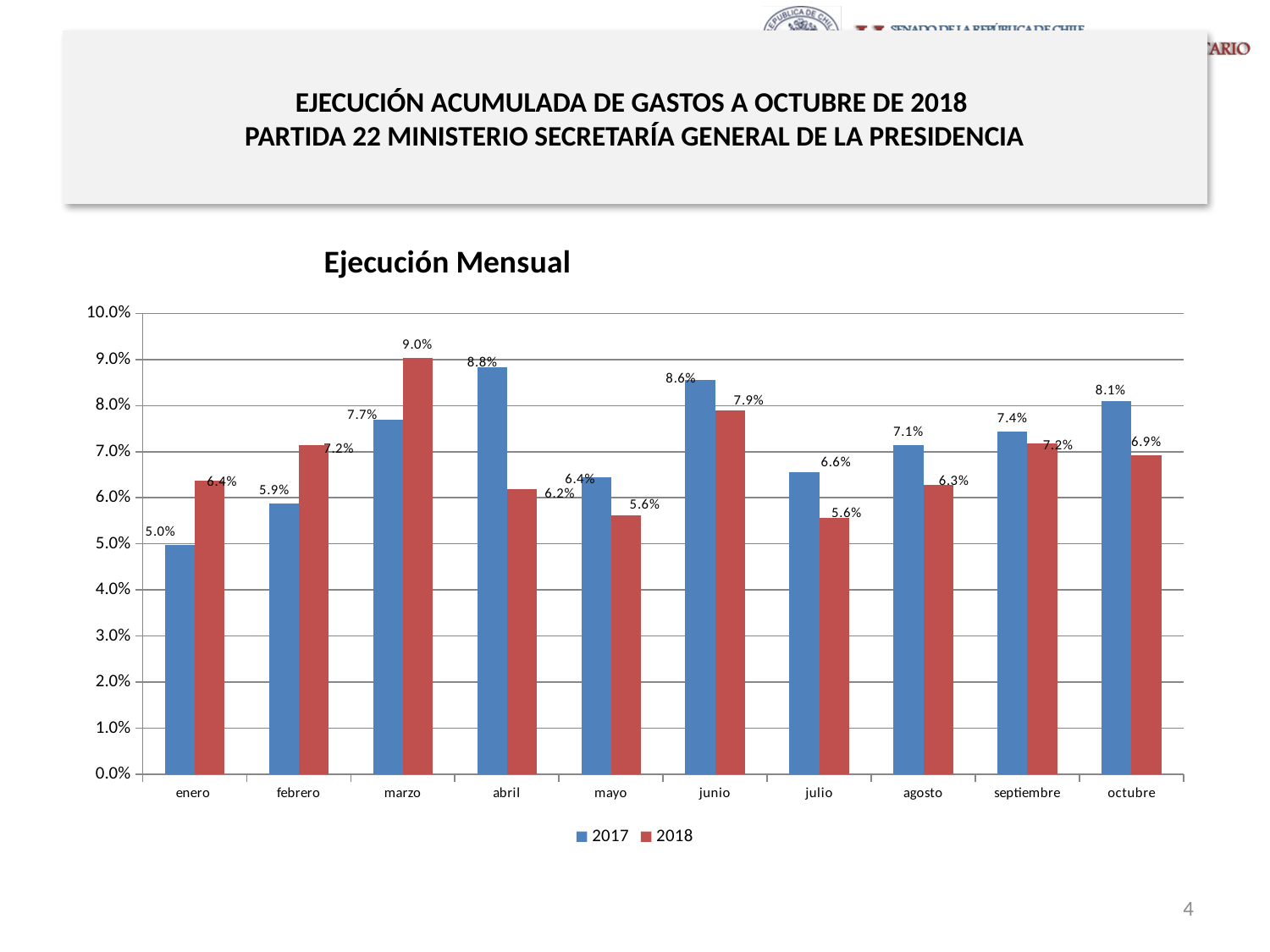
What is the value for 2017 in enero? 5.0% Which month has the highest value for the 2018 series? marzo What is the value for 2018 in marzo? 9.0% Which month has the lowest value for the 2017 series? enero What is the value for 2018 in octubre? 6.9% What is the difference between the 2018 and 2017 values in marzo? 1.3 percentage points How many series does the legend list? 2 What kind of chart is shown on the slide? Bar chart Which is larger in abril, the 2017 value or the 2018 value? 2017 How many months are shown on the x axis? 10 What is the title of the chart? Ejecución Mensual What is the value for 2017 in abril? 8.8%